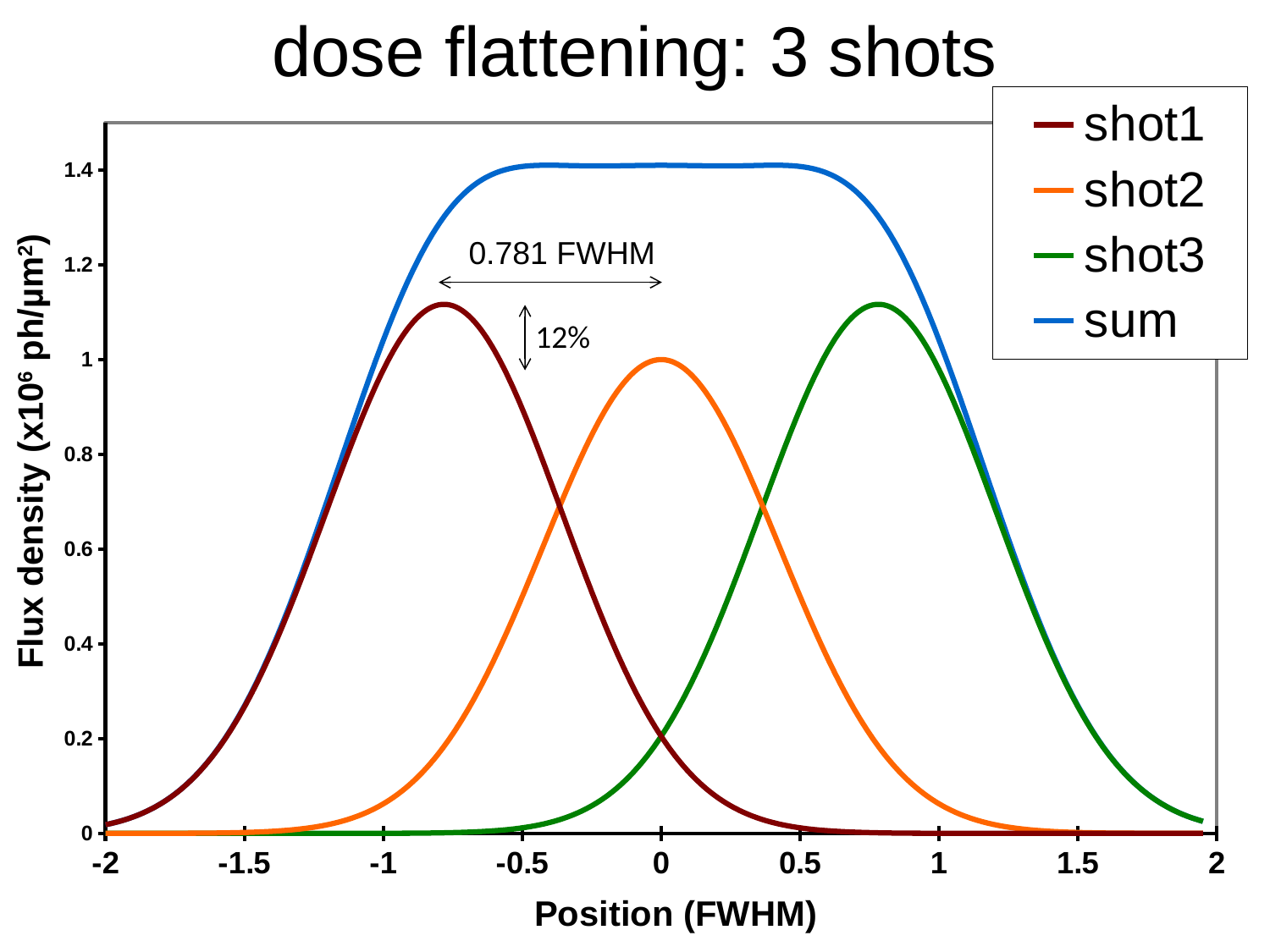
At position 0, which is larger: sum or shot2? sum What is the peak flux density of shot2, at position 0? 1 How many series does the legend list? 4 Does the shot3 curve rise or fall between position 1 and position 2? fall Is the value of shot1 at position 0.5 greater or less than 0.2? less Which series reaches the highest flux density? sum What is the title of the chart? dose flattening: 3 shots Is the value of sum at position 0 greater or less than 1.2? greater Is the value of shot3 at position -0.5 greater or less than 0.2? less What kind of chart is shown on the slide? line chart At position -1, which is larger: shot1 or shot3? shot1 What peak spacing is annotated between the shot1 and shot2 peaks? 0.781 FWHM